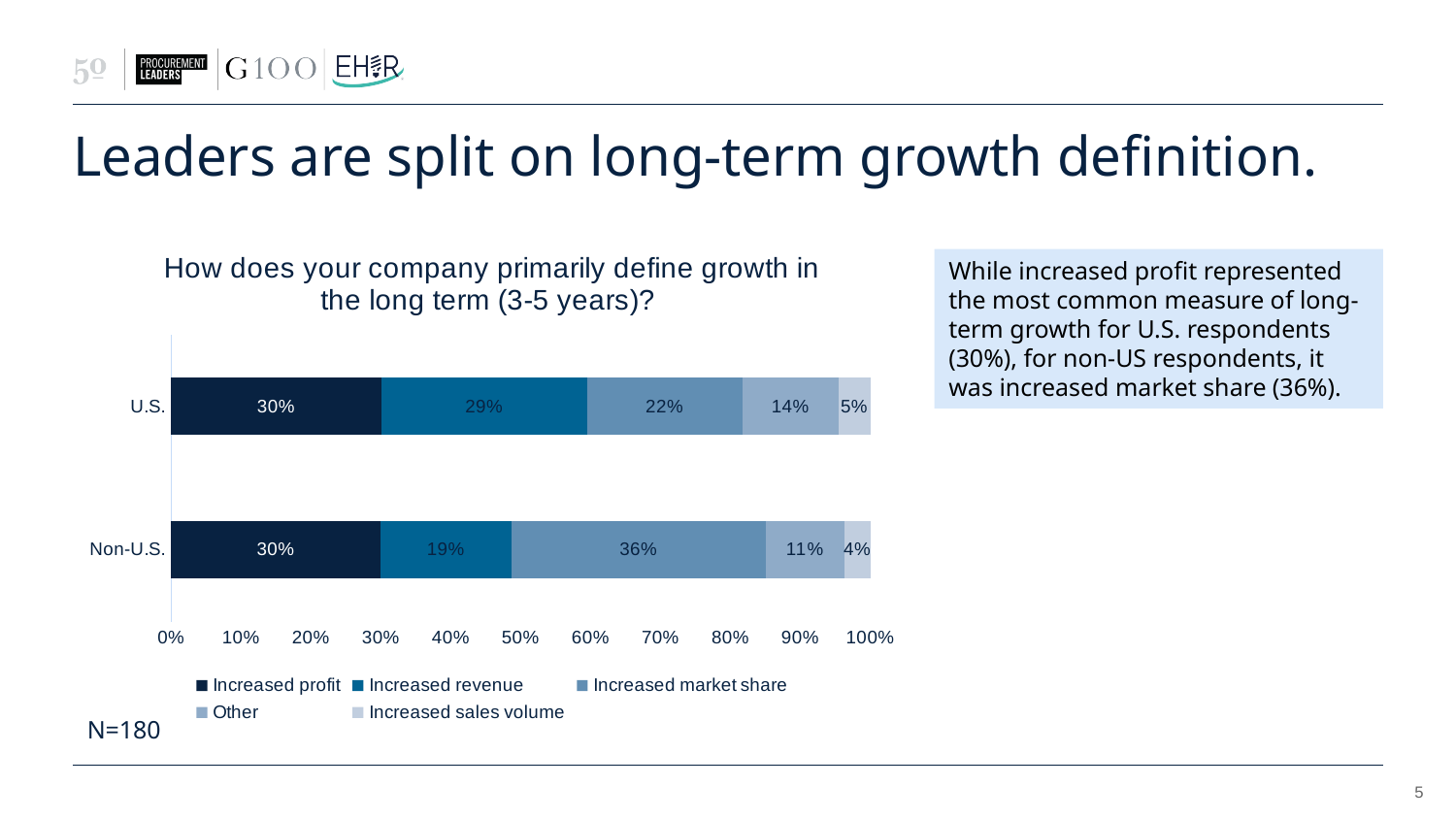
What is the value for Increased sales volume in the Non-U.S. bar? 4% What percentage of U.S. respondents define long-term growth as increased profit? 30% Which group has a higher value for Increased revenue, U.S. or Non-U.S.? U.S. How many series does the legend list? 5 Which segment is the smallest in the U.S. bar? Increased sales volume What is the difference between the Increased market share values for Non-U.S. and U.S. respondents? 14 percentage points Which segment is the largest in the Non-U.S. bar? Increased market share What is the value for Other in the U.S. bar? 14% What type of chart is shown on the slide? Stacked bar chart What percentage of Non-U.S. respondents define long-term growth as increased market share? 36% What is the value for Increased revenue in the Non-U.S. bar? 19% What is the total of the U.S. stacked bar? 100%